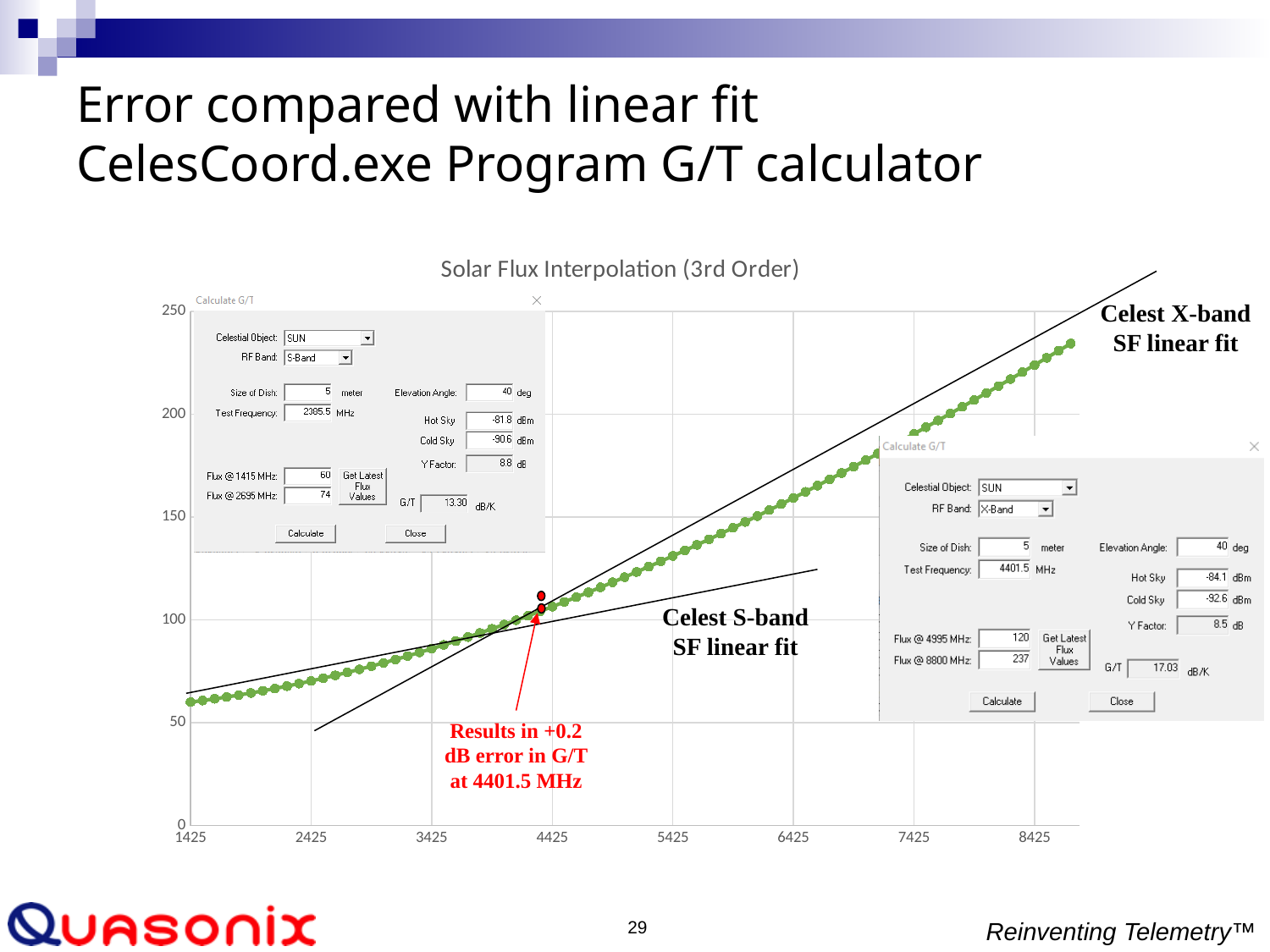
What kind of chart is shown on the slide? line chart Is the plotted value at 5425 greater or less than 100? greater According to the red annotation, what is the G/T error at 4401.5 MHz? +0.2 dB Is the plotted value at 8425 greater or less than 200? greater Is the plotted value at 2425 greater or less than 100? less Which is larger, the plotted value at 7425 or the plotted value at 3425? 7425 What is the title of the chart? Solar Flux Interpolation (3rd Order) At which x-axis value is the plotted curve highest? 8425 Do the plotted values rise or fall as the x axis increases from 1425 to 8425? rise At which x-axis value is the plotted curve lowest? 1425